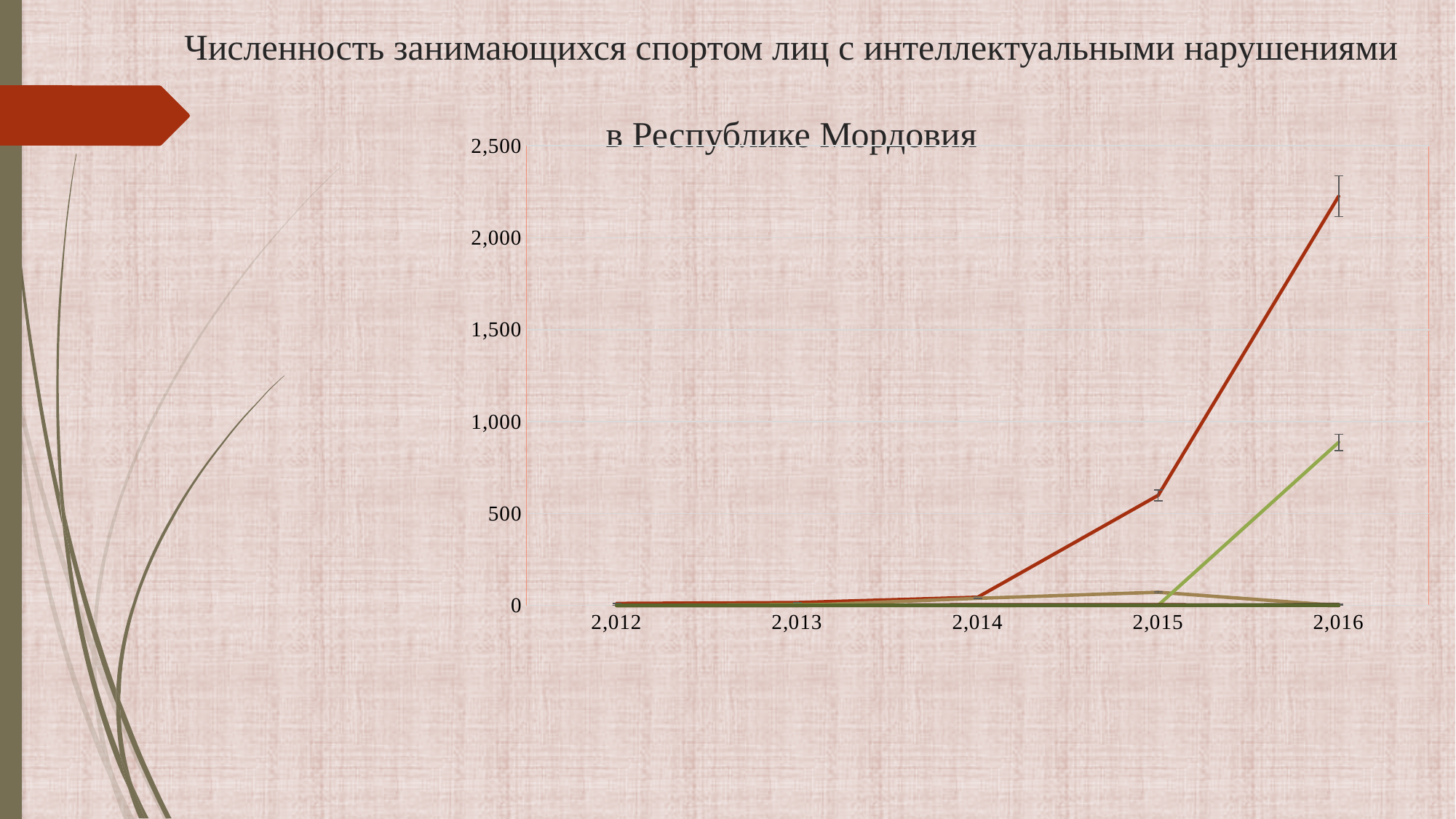
Is the value of the red line in 2,016 greater or less than 2,000? greater In which year does the red line reach its highest value? 2,016 Does the red line rise or fall from 2,012 to 2,016? rise Is the value of the red line in 2,015 greater or less than 500? greater What is the first year shown on the x axis? 2,012 Is the value of the green line in 2,016 greater or less than 1,000? less In 2,016, which line has the larger value, the red line or the green line? the red line What kind of chart is shown on the slide? line chart What is the highest value shown on the y axis of the chart? 2,500 How many years are shown along the x axis of the chart? 5